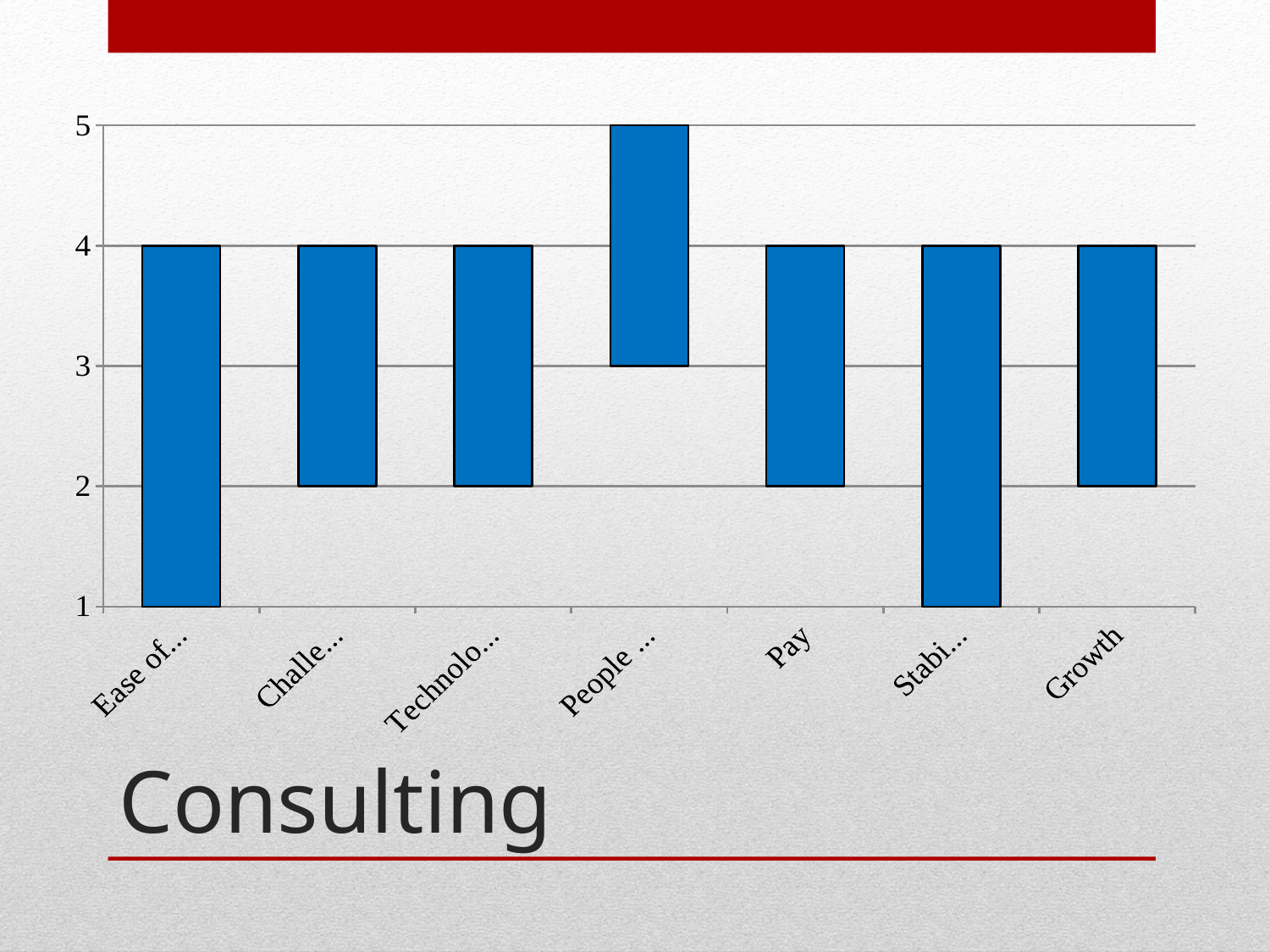
What value does the top of the Growth bar reach on the axis? 4 What is the lowest value any bar extends down to? 1 What is the difference between the top and bottom values of the Growth bar? 2 Which bar reaches the highest value on the axis? the fourth bar from the left What is the title text shown below the chart? Consulting What value does the bottom of the Pay bar sit at on the axis? 2 What value does the bottom of the Growth bar sit at on the axis? 2 What is the highest value reached by any bar in the chart? 5 Is the top of the Pay bar greater or less than 3? greater What value does the top of the Pay bar reach on the axis? 4 How many bars are plotted in the chart? 7 What kind of chart is shown on the slide? bar chart